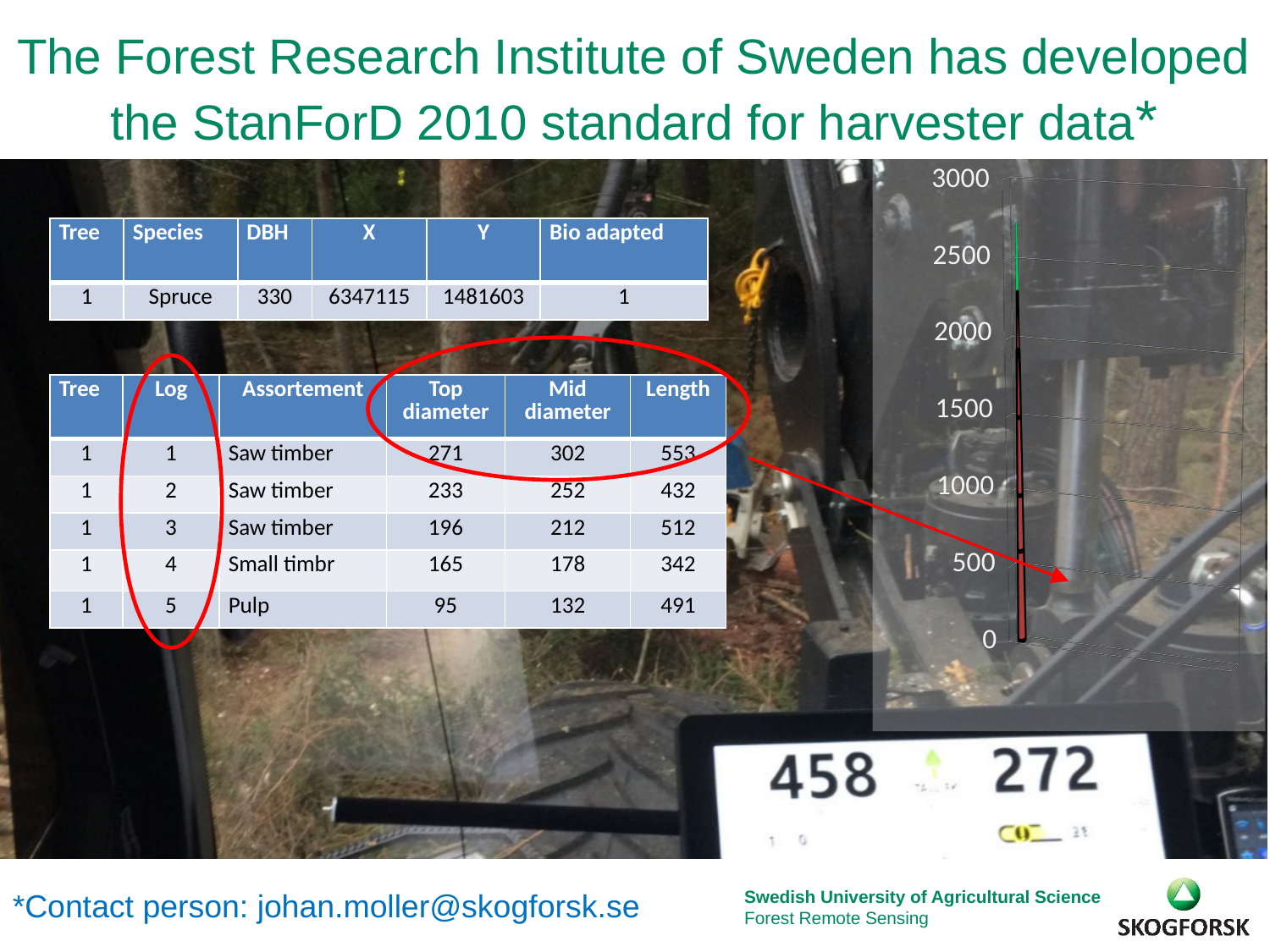
In the bar chart on the right side of the slide, is the top of the bar greater or less than 1500? greater What kind of chart is overlaid on the right side of the slide, next to the axis labelled 0 to 3000? bar chart In the bar chart on the right side of the slide, is the top of the bar greater or less than 3000? less On the bar chart on the right side of the slide, what is the highest value shown on the vertical axis? 3000 In the bar chart on the right side of the slide, what is the interval between consecutive tick labels on the vertical axis? 500 In the bar chart on the right side of the slide, is the top of the bar greater or less than 2000? greater How many bars are plotted in the bar chart on the right side of the slide? 1 On the bar chart on the right side of the slide, what is the lowest value shown on the vertical axis? 0